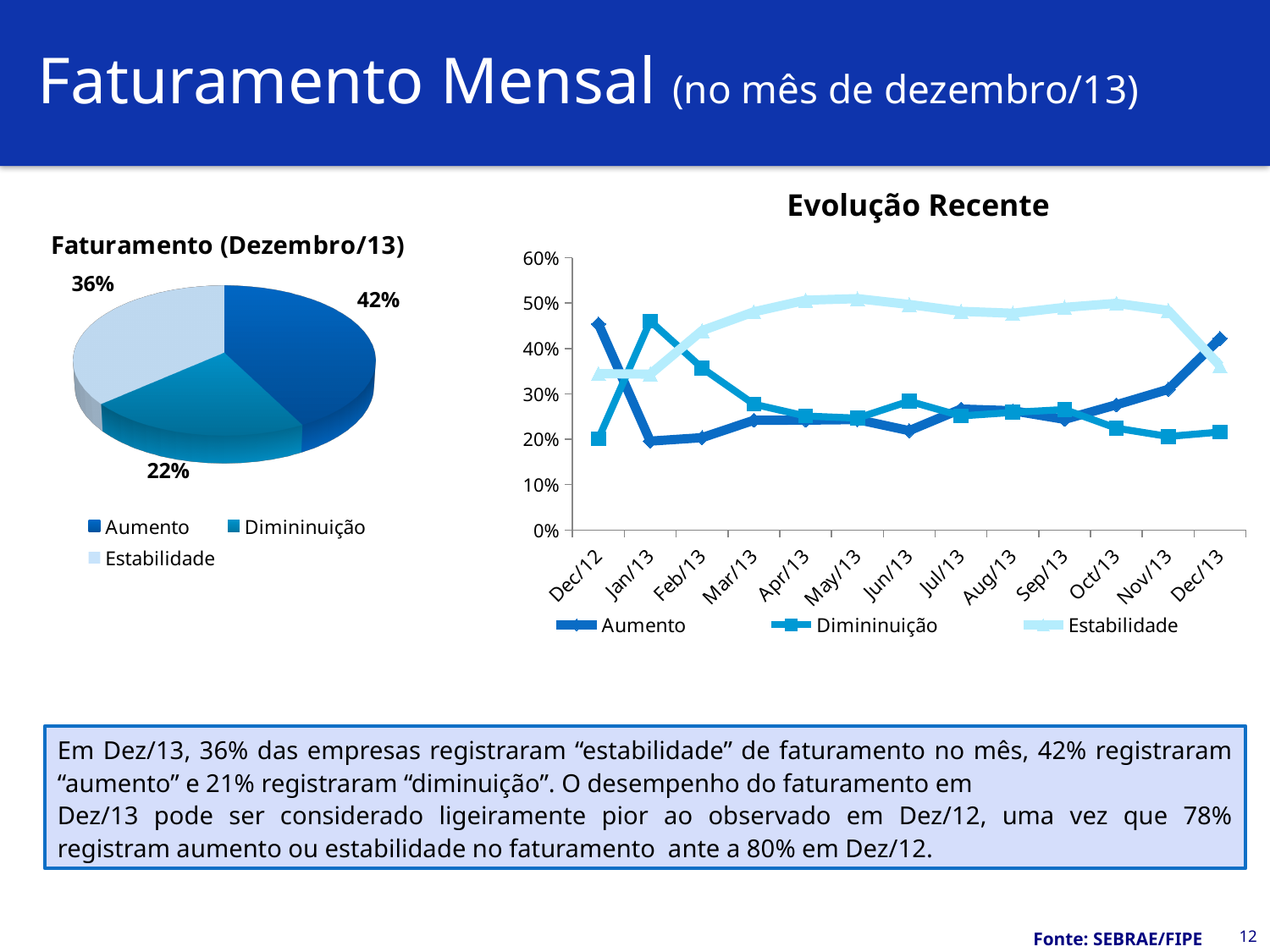
What kind of chart is 'Evolução Recente'? Line chart How many series does the legend of the 'Evolução Recente' chart list? 3 In the 'Evolução Recente' chart, which series is higher in Jan/13: Aumento or Diminuição? Diminuição In the pie chart 'Faturamento (Dezembro/13)', what is the difference in percentage points between Aumento and Estabilidade? 6 percentage points In the 'Evolução Recente' chart, how many months are plotted along the x axis? 13 In the pie chart 'Faturamento (Dezembro/13)', which category has the smallest slice? Diminuição In the pie chart 'Faturamento (Dezembro/13)', what share is labelled for Aumento? 42% In the pie chart 'Faturamento (Dezembro/13)', which category has the largest slice? Aumento In the pie chart 'Faturamento (Dezembro/13)', what share is labelled for Estabilidade? 36% In the pie chart 'Faturamento (Dezembro/13)', what share is labelled for Diminuição? 22% In the 'Evolução Recente' chart, is the value for Estabilidade in May/13 greater or less than 40%? greater In the pie chart 'Faturamento (Dezembro/13)', how many slices are there? 3